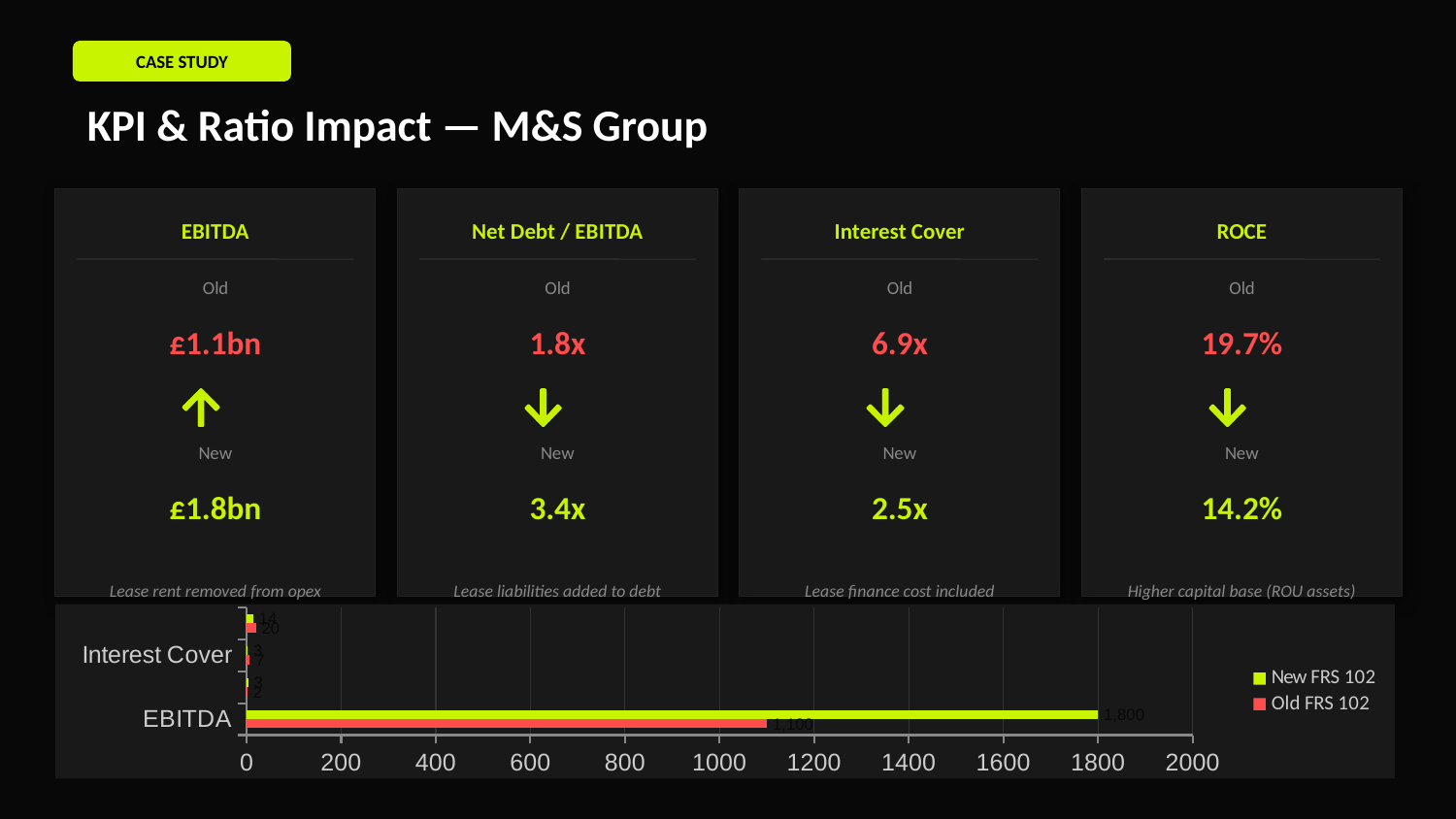
In the bar chart, what is the difference between the New FRS 102 and Old FRS 102 EBITDA values? 700 In the bar chart, what is the EBITDA value for the Old FRS 102 series? 1,100 In the bar chart, is the Old FRS 102 EBITDA value greater or less than 1200? less In the bar chart, is the New FRS 102 EBITDA value greater or less than 1600? greater In the bar chart, which series has the larger EBITDA value, New FRS 102 or Old FRS 102? New FRS 102 In the bar chart, what is the EBITDA value for the New FRS 102 series? 1,800 How many series does the legend of the bar chart list? 2 In the bar chart, is the Old FRS 102 EBITDA value greater or less than 1000? greater What colour represents the New FRS 102 series in the bar chart? green What are the two legend entries of the bar chart? New FRS 102 and Old FRS 102 What kind of chart is shown at the bottom of the slide? bar chart